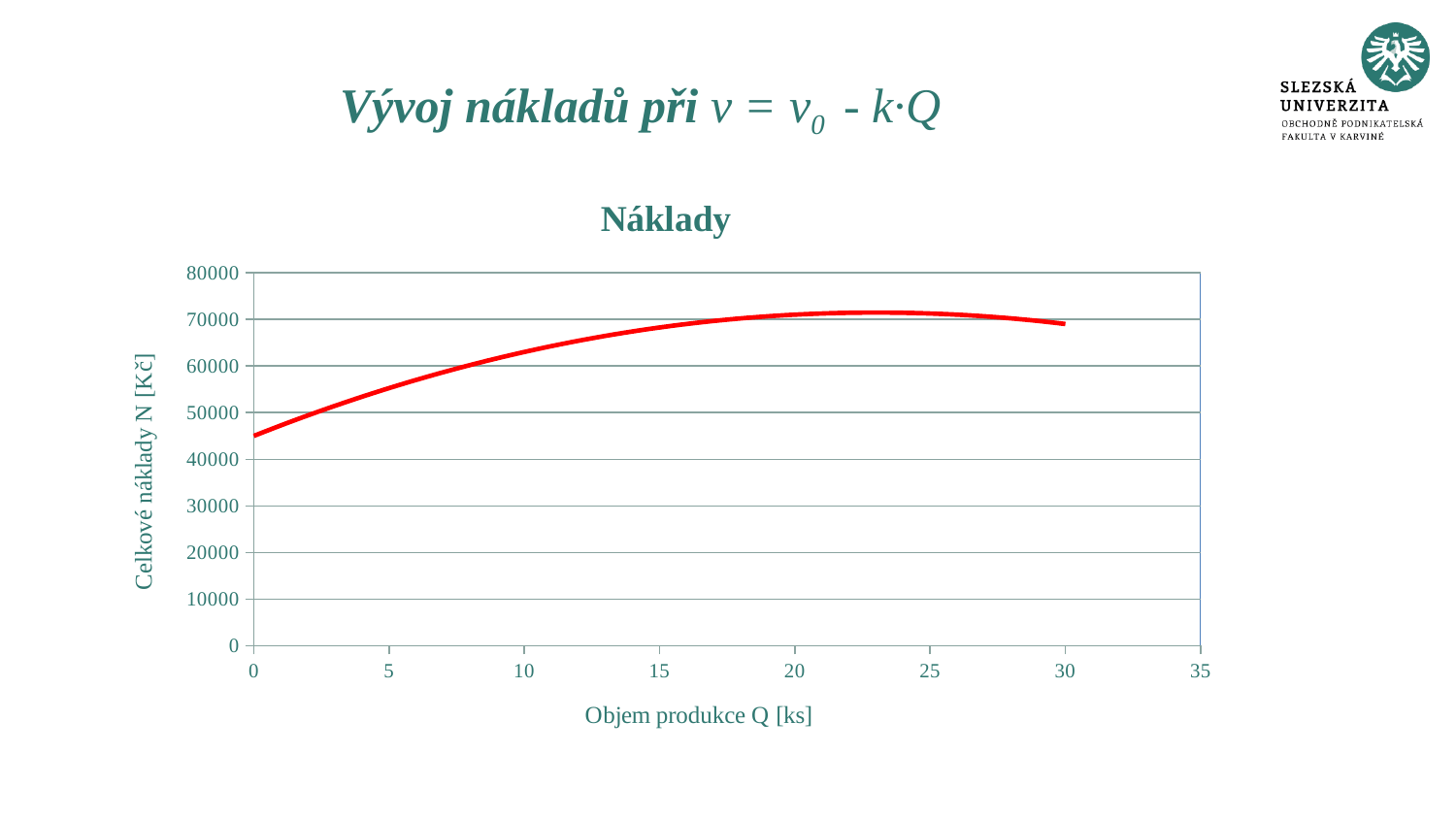
Is the value of the curve at Q = 5 greater or less than 50000? greater What is the label of the x axis of the chart? Objem produkce Q [ks] Is the value of the curve at Q = 25 greater or less than 60000? greater What is the title of the chart? Náklady What kind of chart is shown on the slide? line chart Do the costs rise or fall as Q increases from 0 to 15? rise Do the costs rise or fall as Q increases from 25 to 30? fall Is the value of the curve at Q = 30 greater or less than the value at Q = 0? greater Is the value of the curve at Q = 15 greater or less than 60000? greater